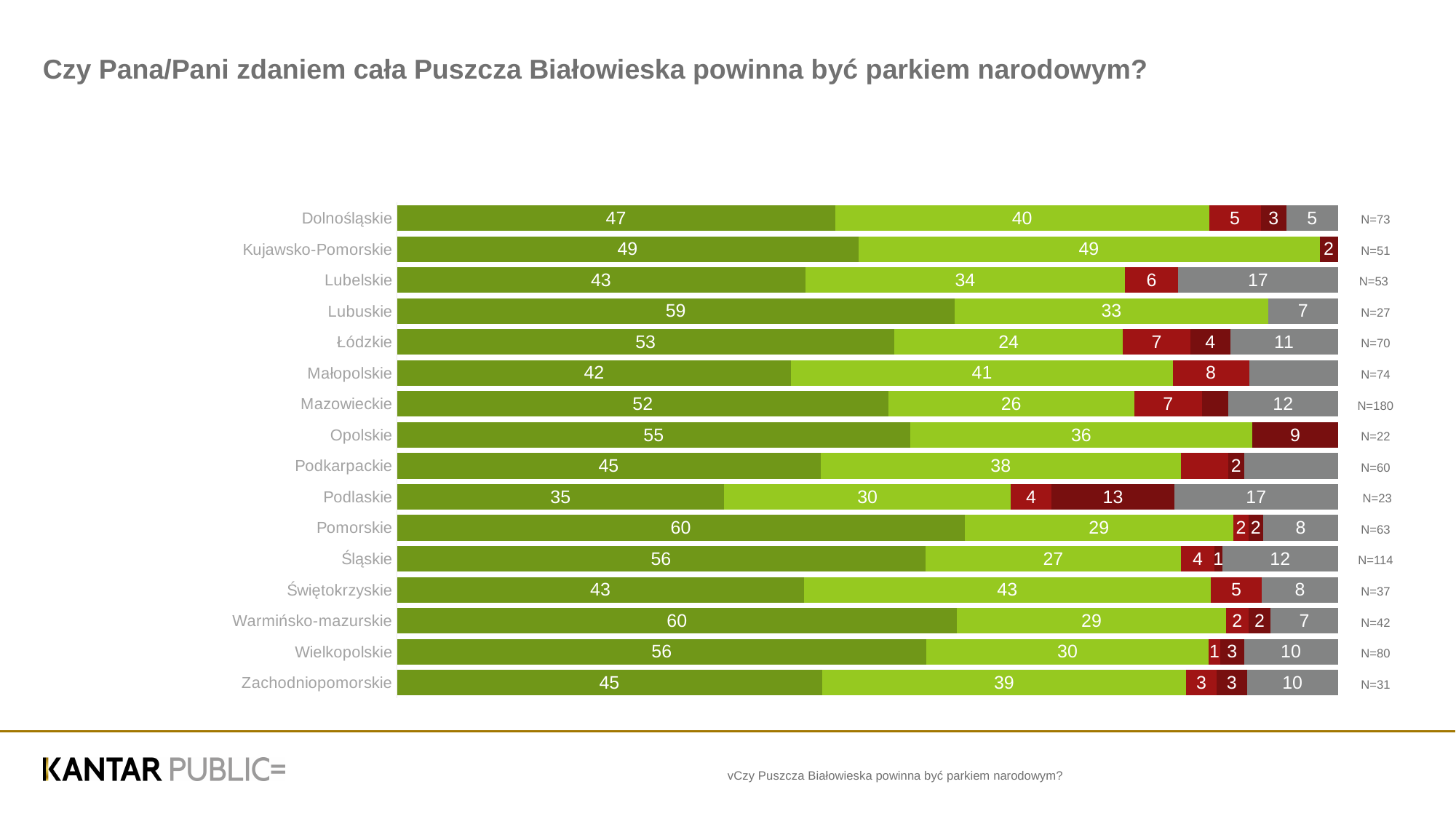
What is the total of all segments in the Dolnośląskie bar? 100 What is the value of the dark red segment for Podlaskie? 13 What is the value of the first (dark green) segment for Lubuskie? 59 What is the value of the second (light green) segment for Kujawsko-Pomorskie? 49 How many regions (categories) are listed on the chart? 16 What sample size (N) is shown for Mazowieckie? N=180 What is the value of the grey segment for Lubelskie? 17 Which region has the lowest value in the first (dark green) segment? Podlaskie What kind of chart is shown on the slide? Stacked bar chart What is the difference between the first (dark green) segment values for Lubuskie and Podlaskie? 24 Which region has the highest value in the second (light green) segment? Kujawsko-Pomorskie Which has the larger first (dark green) segment value, Opolskie or Małopolskie? Opolskie